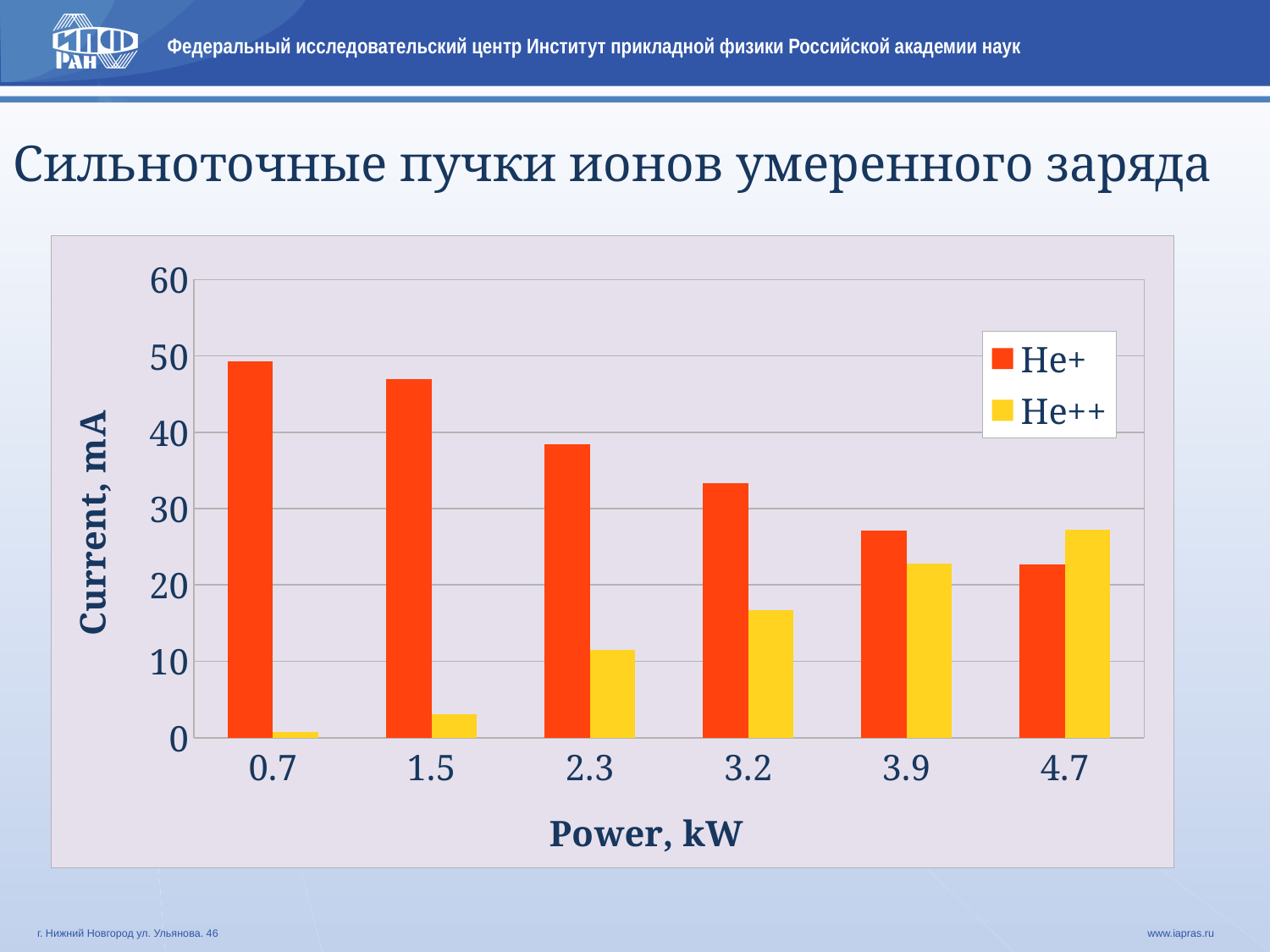
Does the He++ current rise or fall as power increases along the x axis? rise At which power is the He++ current highest? 4.7 Does the He+ current rise or fall as power increases along the x axis? fall At 4.7 kW, which is larger, the He+ current or the He++ current? He++ Is the He+ current at 0.7 kW greater or less than 40? greater What is the title of the y axis? Current, mA At which power is the He+ current lowest? 4.7 How many series does the legend list? 2 At which power is the He++ current lowest? 0.7 How many power values are shown on the x axis? 6 What kind of chart is shown on the slide? bar chart At which power is the He+ current highest? 0.7